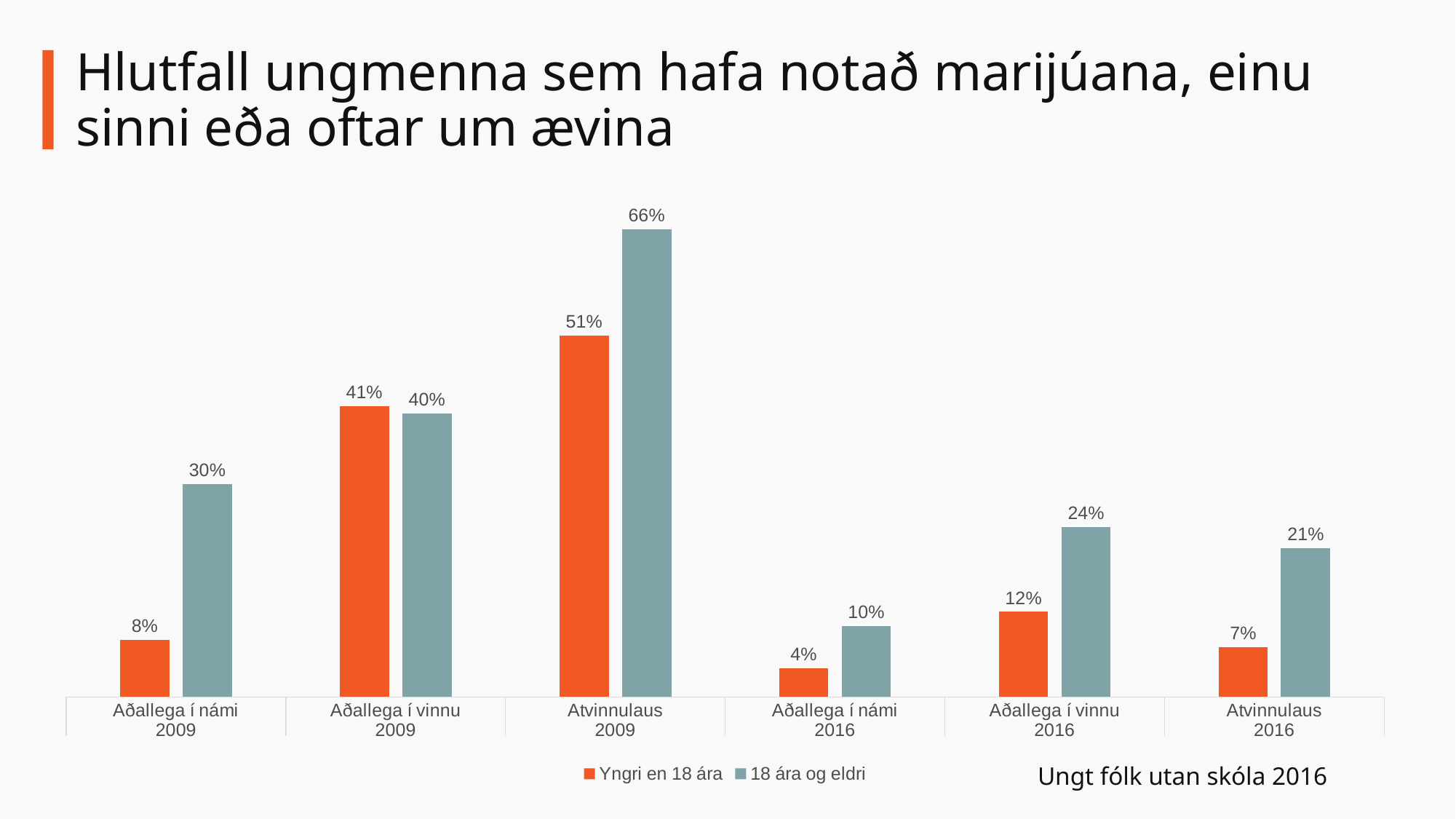
Which is larger in the "Aðallega í vinnu 2009" category: "Yngri en 18 ára" or "18 ára og eldri"? Yngri en 18 ára Which category has the lowest value for the "Yngri en 18 ára" series? Aðallega í námi 2016 Which colour represents the "Yngri en 18 ára" series? Orange What is the value for "18 ára og eldri" in the "Atvinnulaus 2009" category? 66% What is the value for "Yngri en 18 ára" in the "Aðallega í vinnu 2009" category? 41% How many series does the legend list? 2 How many categories are shown on the x axis? 6 Which category has the highest value for the "18 ára og eldri" series? Atvinnulaus 2009 What is the value for "Yngri en 18 ára" in the "Aðallega í námi 2016" category? 4% What kind of chart is shown on the slide? Bar chart What is the difference between the "18 ára og eldri" values for "Atvinnulaus 2009" and "Atvinnulaus 2016"? 45% What is the difference between the "18 ára og eldri" and "Yngri en 18 ára" values in the "Aðallega í námi 2009" category? 22%